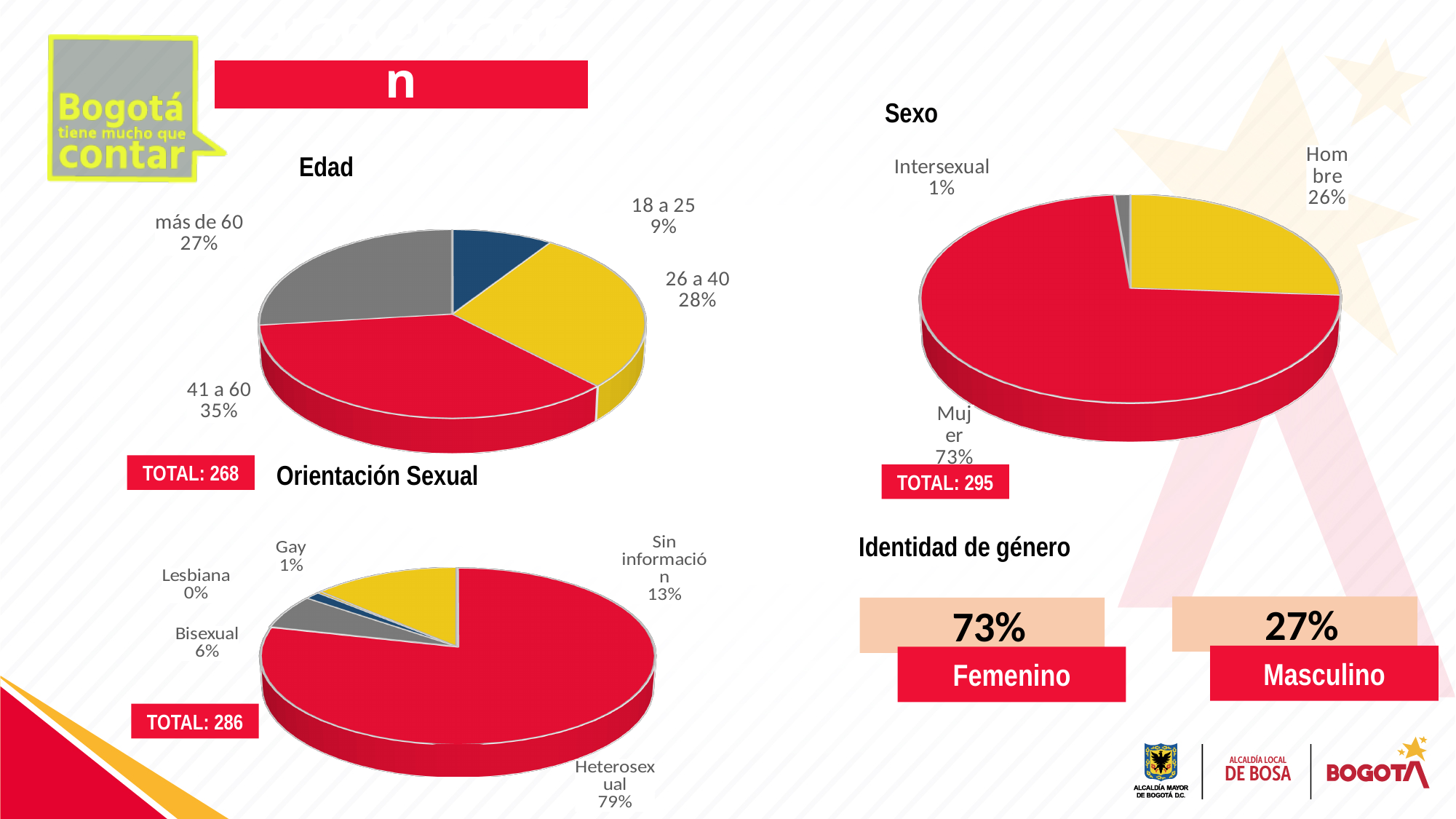
How many categories does the Orientación Sexual pie chart show? 5 In the Sexo pie chart, is the share for Hombre larger or smaller than the share for Mujer? smaller In the Edad pie chart, which age group has the smallest share? 18 a 25 In the Orientación Sexual pie chart, which category has the largest share? Heterosexual In the Edad pie chart, what share is shown for the 41 a 60 category? 35% In the Orientación Sexual pie chart, what share is shown for Bisexual? 6% In the Edad pie chart, what is the difference in percentage points between the 26 a 40 and 18 a 25 slices? 19 What type of chart is used for the Sexo data? pie chart In the Edad pie chart, which age group has the largest share? 41 a 60 How many categories does the Edad pie chart show? 4 In the Sexo pie chart, what share is shown for Mujer? 73% In the Sexo pie chart, which category has the smallest share? Intersexual